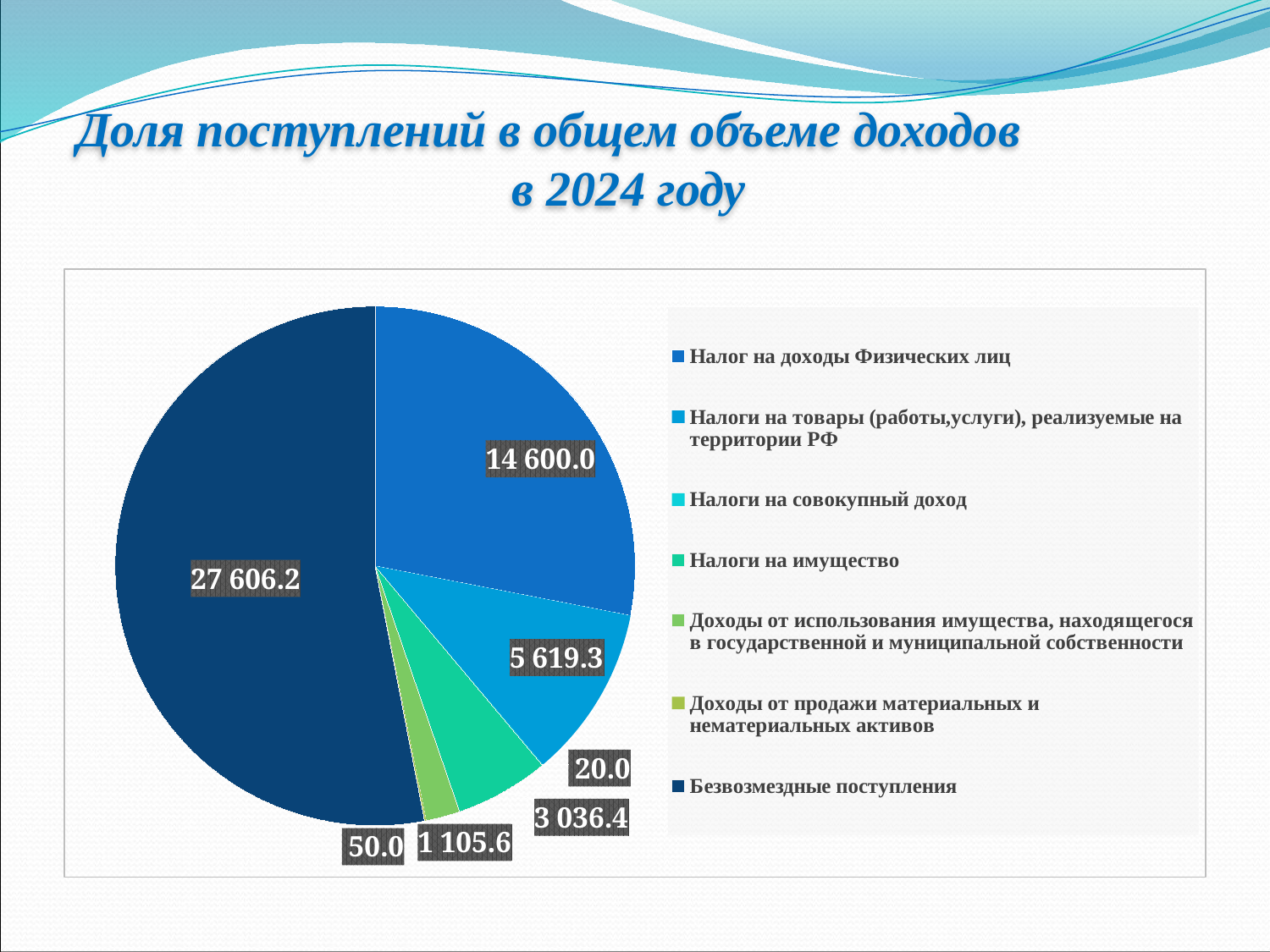
What is the value for Налоги на имущество? 3 036.4 Which category has the largest slice of the pie? Безвозмездные поступления What is the value for Налоги на совокупный доход? 20.0 What is the value for Безвозмездные поступления? 27 606.2 Which category has the smallest slice of the pie? Налоги на совокупный доход What is the title of the slide? Доля поступлений в общем объеме доходов в 2024 году What is the difference between Безвозмездные поступления and Налог на доходы Физических лиц? 13 006.2 Which is larger: Налоги на имущество or Доходы от использования имущества, находящегося в государственной и муниципальной собственности? Налоги на имущество How many categories does the pie chart have? 7 What type of chart is shown on the slide? pie chart What is the value for Налог на доходы Физических лиц? 14 600.0 What is the difference between Налог на доходы Физических лиц and Налоги на товары (работы,услуги), реализуемые на территории РФ? 8 980.7